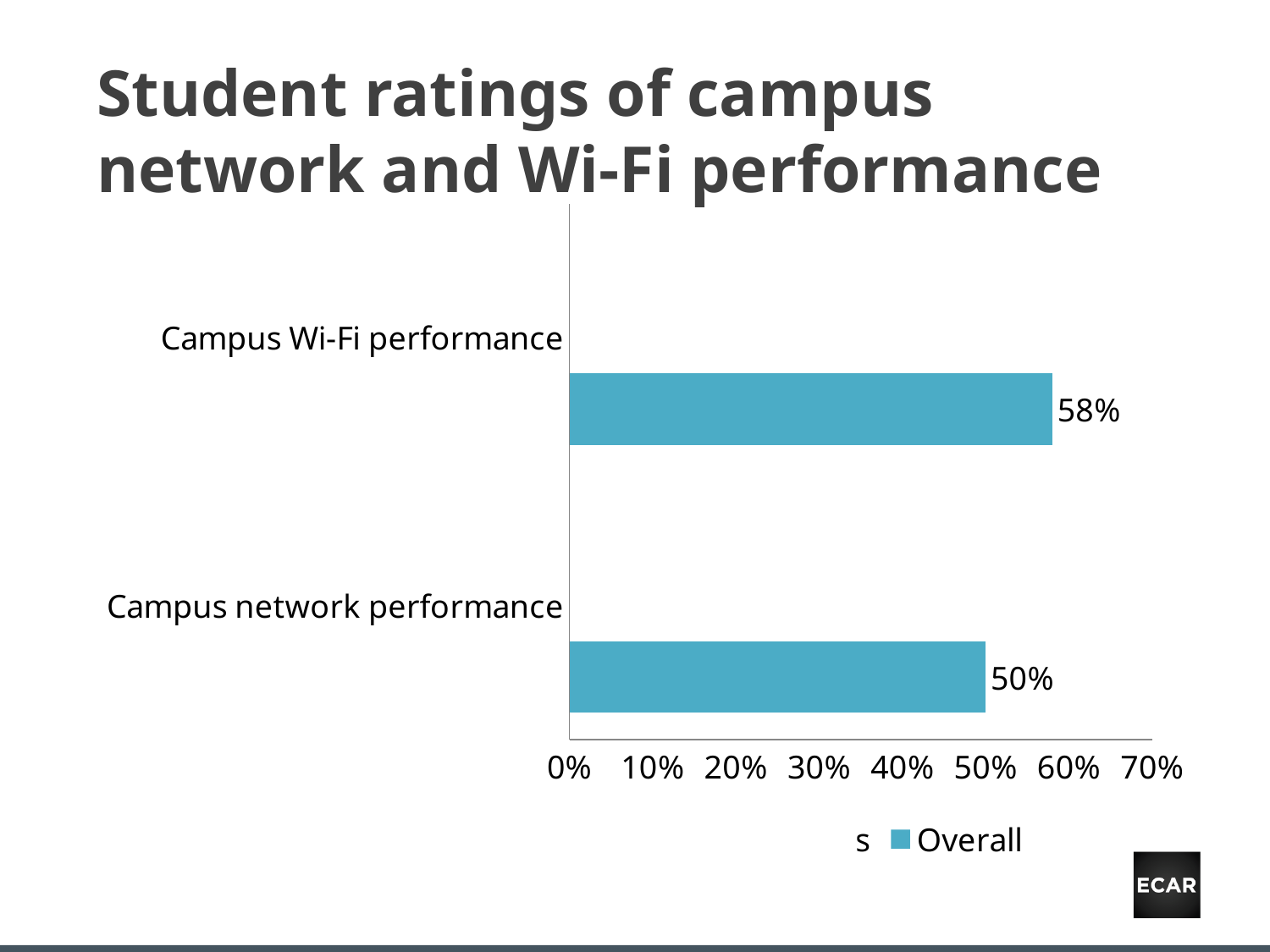
Which category has the lowest value? Campus network performance Which category has the highest value? Campus Wi-Fi performance What is the title of the slide? Student ratings of campus network and Wi-Fi performance Which is larger, the value for Campus Wi-Fi performance or the value for Campus network performance? Campus Wi-Fi performance What is the difference between the values for Campus Wi-Fi performance and Campus network performance? 8% Is the value for Campus network performance greater or less than 60%? less What kind of chart is shown on the slide? Bar chart How many categories are shown in the chart? 2 Is the value for Campus Wi-Fi performance greater or less than 50%? greater What is the value for Campus Wi-Fi performance? 58% What is the highest value shown on the horizontal axis? 70% What is the value for Campus network performance? 50%